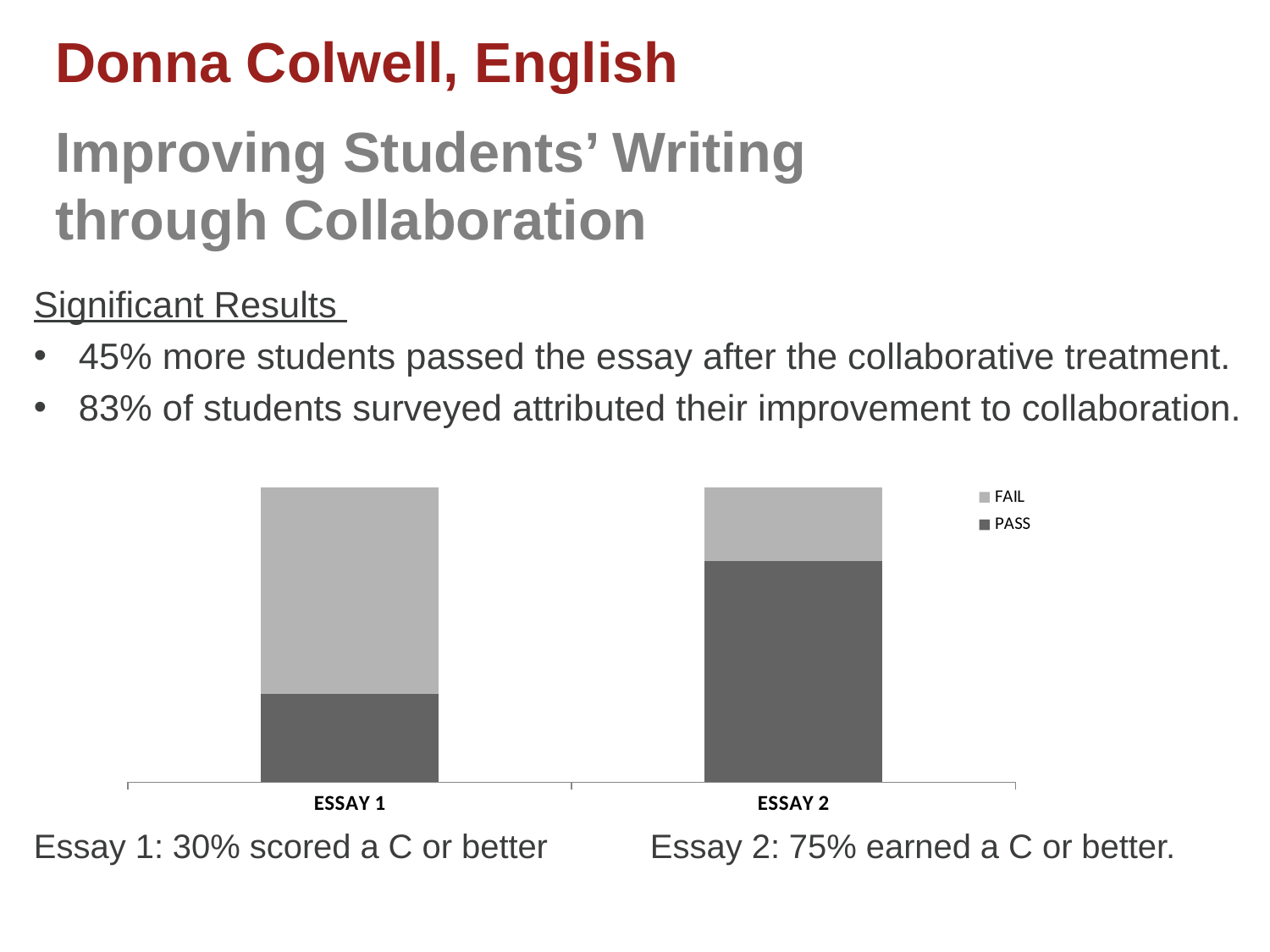
Which category has the larger FAIL segment, ESSAY 1 or ESSAY 2? ESSAY 1 Which series is drawn in the darker grey colour? PASS How many series does the chart's legend list? 2 Which category has the highest PASS value? ESSAY 2 In the ESSAY 1 bar, which segment is larger, FAIL or PASS? FAIL In the ESSAY 2 bar, which segment is larger, FAIL or PASS? PASS What are the two series listed in the chart's legend? FAIL and PASS Does the PASS value rise or fall from ESSAY 1 to ESSAY 2? Rise How many categories are shown on the x axis of the chart? 2 Which category has the lowest PASS value? ESSAY 1 What kind of chart is shown on the slide? Stacked bar chart